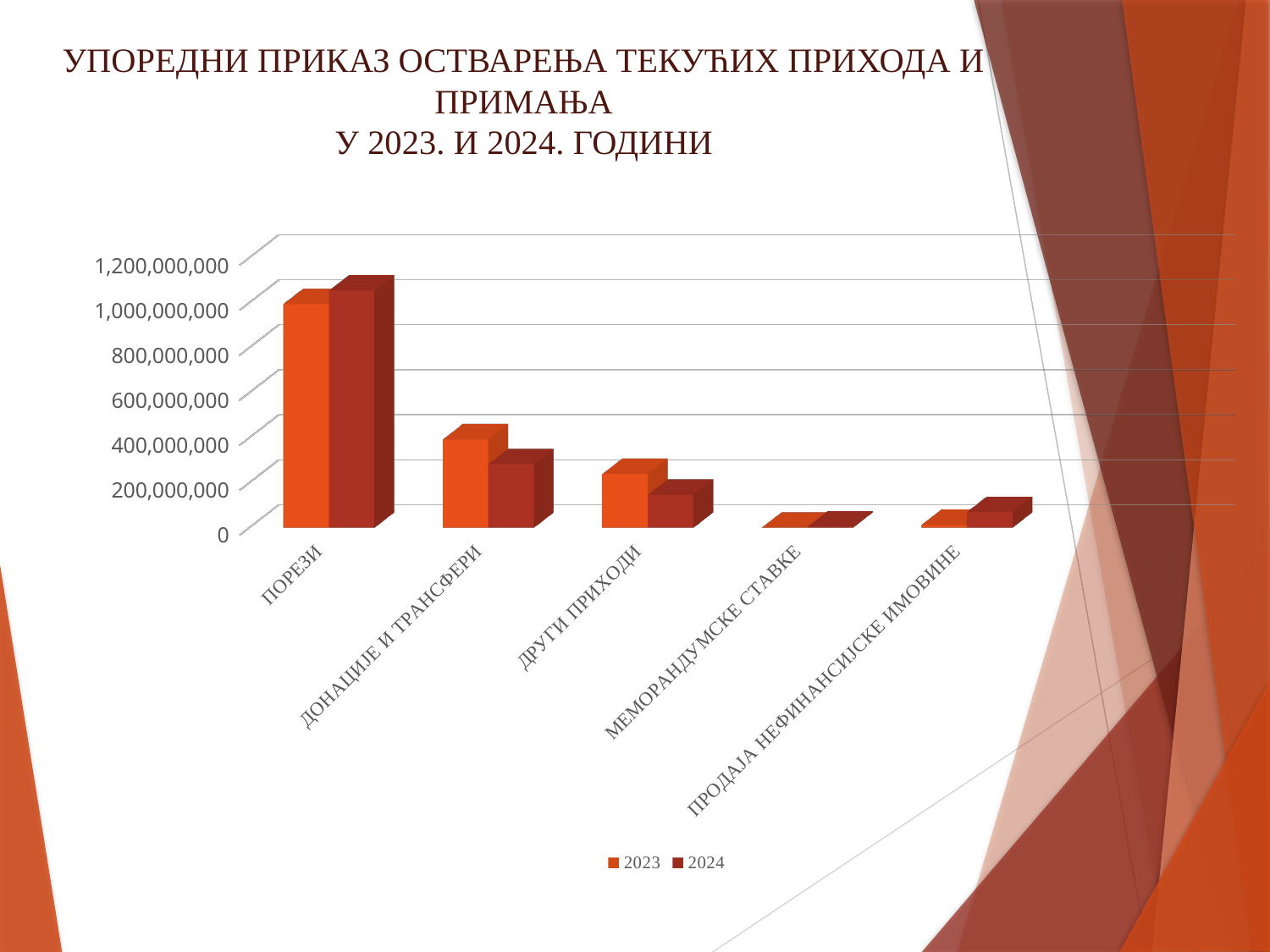
Is the 2023 value for МЕМОРАНДУМСКЕ СТАВКЕ greater or less than 200,000,000? less Is the 2024 value for ДОНАЦИЈЕ И ТРАНСФЕРИ greater or less than 400,000,000? less For ПОРЕЗИ, which year has the larger value, 2023 or 2024? 2024 Which two series are listed in the chart legend? 2023 and 2024 Which category has the highest value for 2023? ПОРЕЗИ Is the 2023 value for ПОРЕЗИ greater or less than 800,000,000? greater For ДОНАЦИЈЕ И ТРАНСФЕРИ, which year has the larger value, 2023 or 2024? 2023 What kind of chart is shown on the slide? bar chart How many series does the chart legend list? 2 How many categories are shown on the x axis of the chart? 5 Which category has the highest value for 2024? ПОРЕЗИ